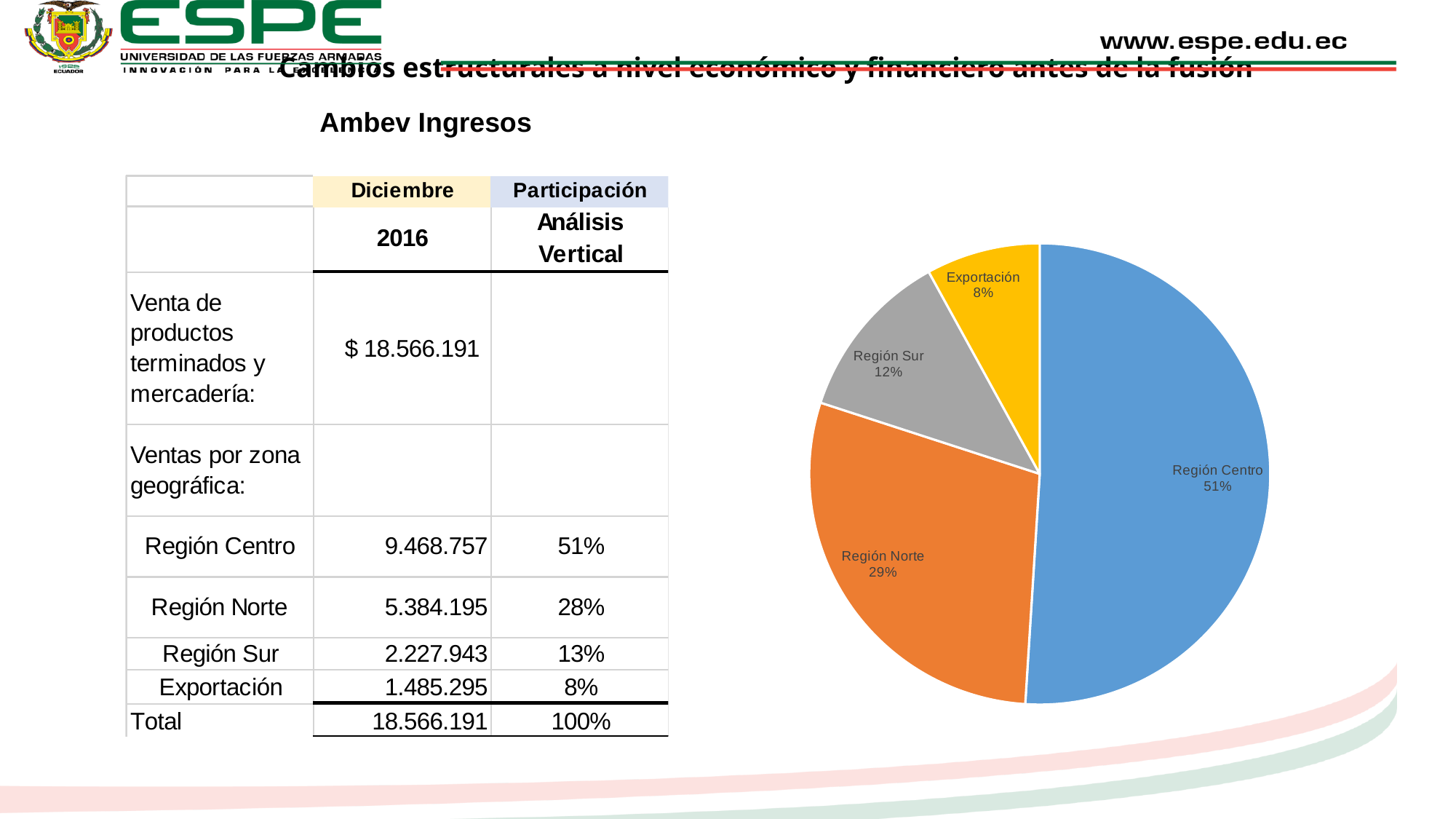
What kind of chart is shown on the slide? pie chart How many slices does the pie chart have? 4 In the pie chart, what is the difference in percentage points between Región Centro and Región Norte? 22 What share of the pie chart does Exportación represent? 8% In the pie chart, which is larger: Región Norte or Región Sur? Región Norte In the pie chart, what is the difference in percentage points between Región Sur and Exportación? 4 Which slice of the pie chart is the largest? Región Centro What share of the pie chart does Región Centro represent? 51% Which slice of the pie chart is the smallest? Exportación What share of the pie chart does Región Sur represent? 12% What colour is the Región Norte slice in the pie chart? orange